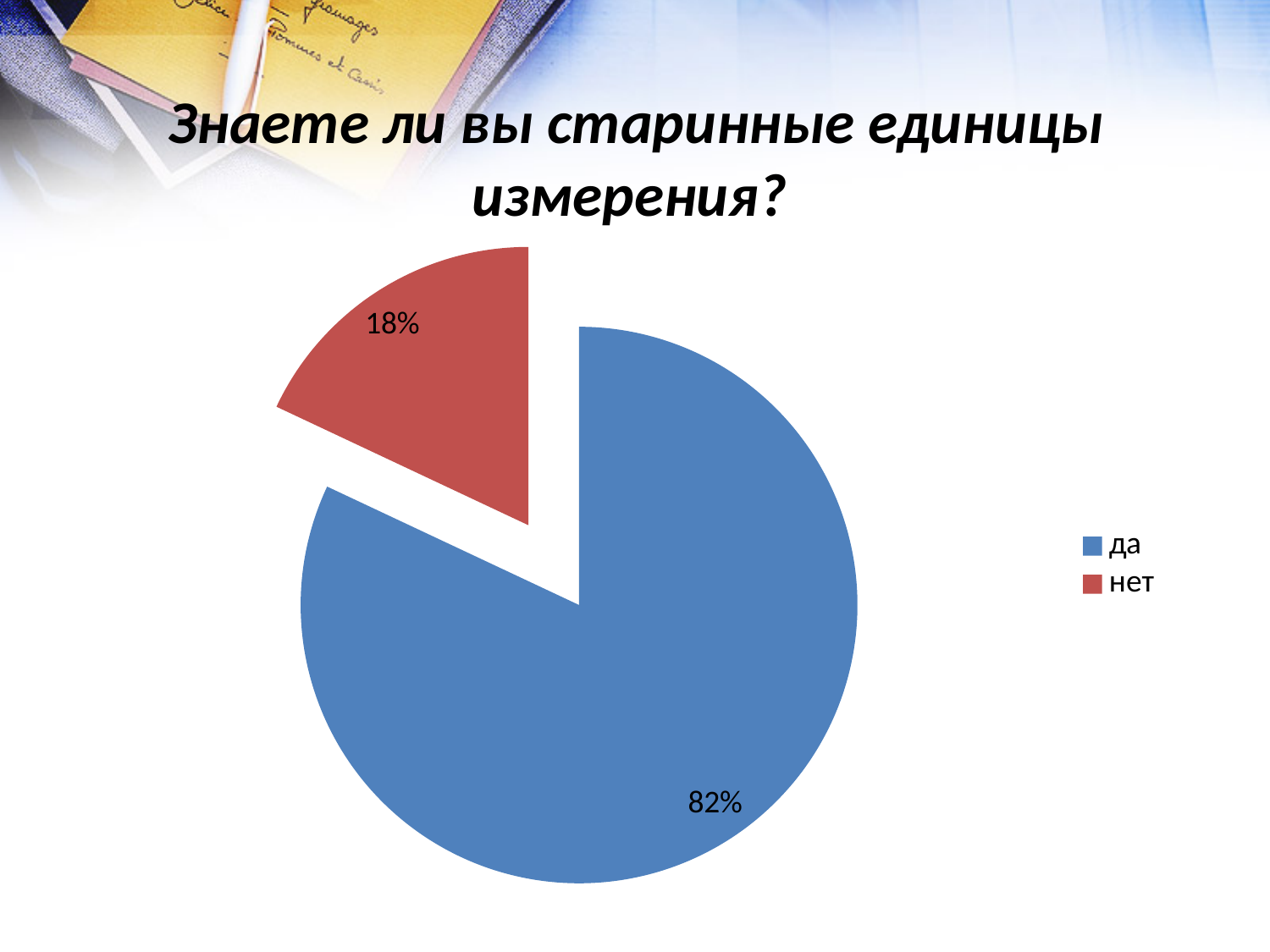
What is the difference in percentage points between the "да" and "нет" slices? 64 What share of the pie does "да" represent? 82% What colour is the "нет" slice? red What kind of chart is shown on the slide? pie chart What is the title of the chart? Знаете ли вы старинные единицы измерения? Which is larger, the "да" slice or the "нет" slice? да How many slices does the pie chart have? 2 Which slice of the pie is the smallest? нет What share of the pie does "нет" represent? 18% Which slice of the pie is the largest? да How many entries does the legend list? 2